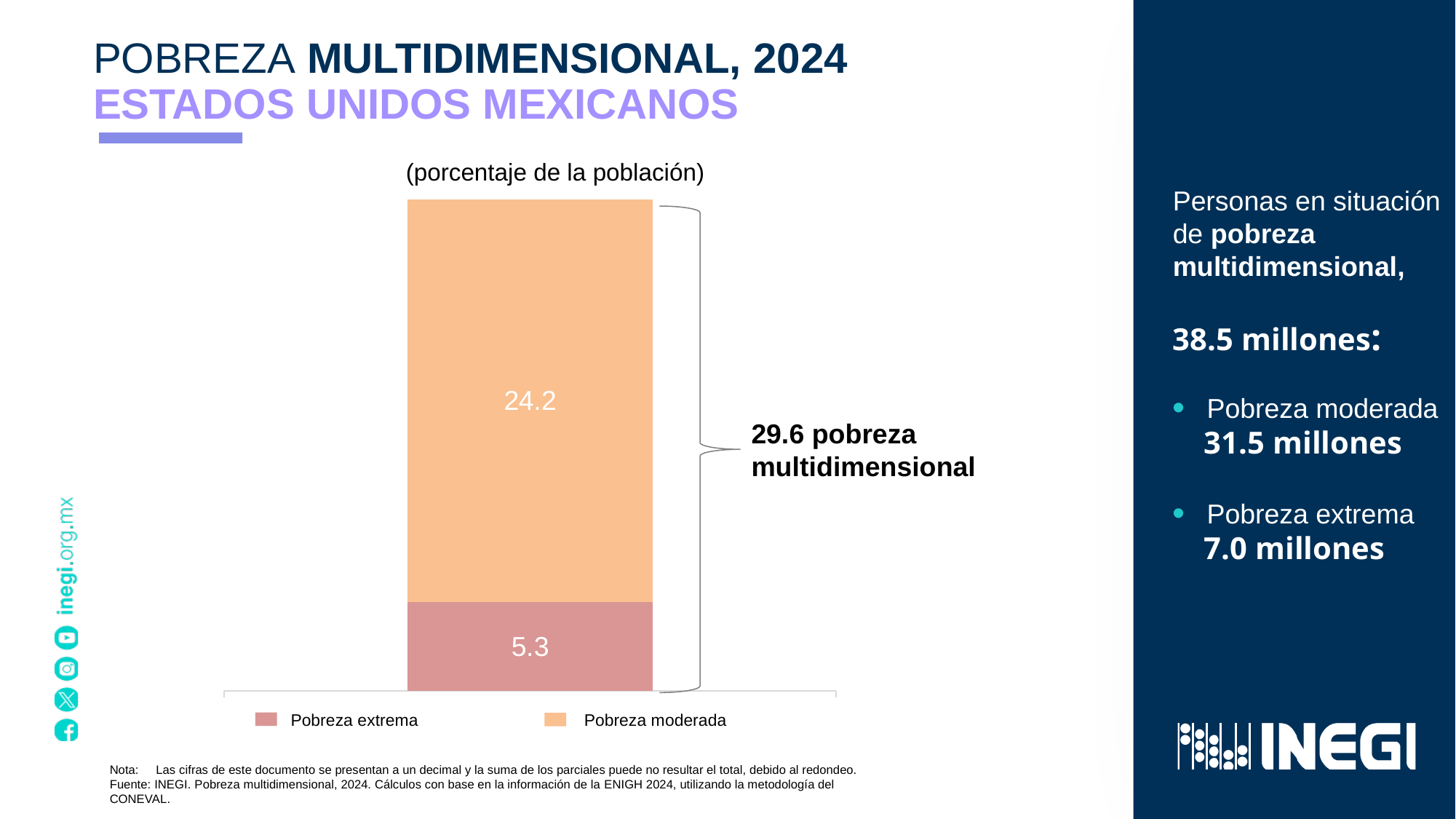
What is the difference between the Pobreza moderada value and the Pobreza extrema value? 18.9 Which series has the largest value in the chart? Pobreza moderada What is the value of the Pobreza moderada segment in the stacked bar? 24.2 What is the value of the Pobreza extrema segment in the stacked bar? 5.3 Which colour represents Pobreza moderada in the legend? Orange How many series does the legend list? 2 Which series has the smallest value in the chart? Pobreza extrema What total is labelled for the stacked bar (pobreza multidimensional)? 29.6 Which segment of the bar is larger, Pobreza extrema or Pobreza moderada? Pobreza moderada What unit does the chart subtitle say the values are in? porcentaje de la población What kind of chart is shown on the slide? Stacked bar chart How many bars are plotted in the chart? 1